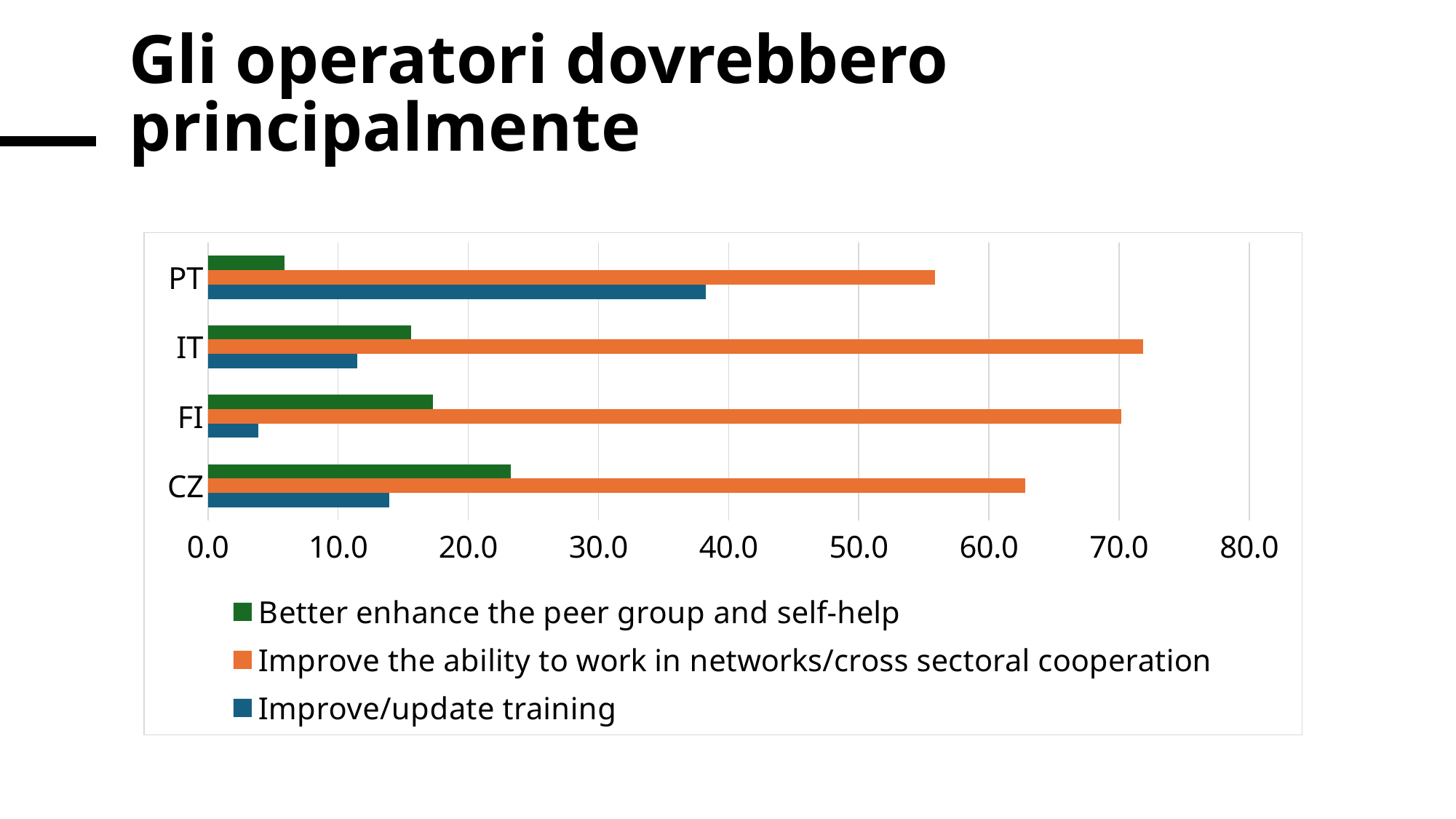
Which country has the lowest value for 'Improve/update training'? FI Which country has the highest value for 'Better enhance the peer group and self-help'? CZ Is the value for 'Improve/update training' in FI greater or less than 10.0? less Which country has the highest value for 'Improve/update training'? PT Which country has the lowest value for 'Improve the ability to work in networks/cross sectoral cooperation'? PT Which country has the lowest value for 'Better enhance the peer group and self-help'? PT For CZ, which is larger: 'Better enhance the peer group and self-help' or 'Improve/update training'? Better enhance the peer group and self-help Is the value for 'Improve/update training' in PT greater or less than 30.0? greater Which colour represents 'Improve the ability to work in networks/cross sectoral cooperation' in the legend? orange What kind of chart is shown on the slide? bar chart How many countries are shown on the chart? 4 How many series does the legend list? 3